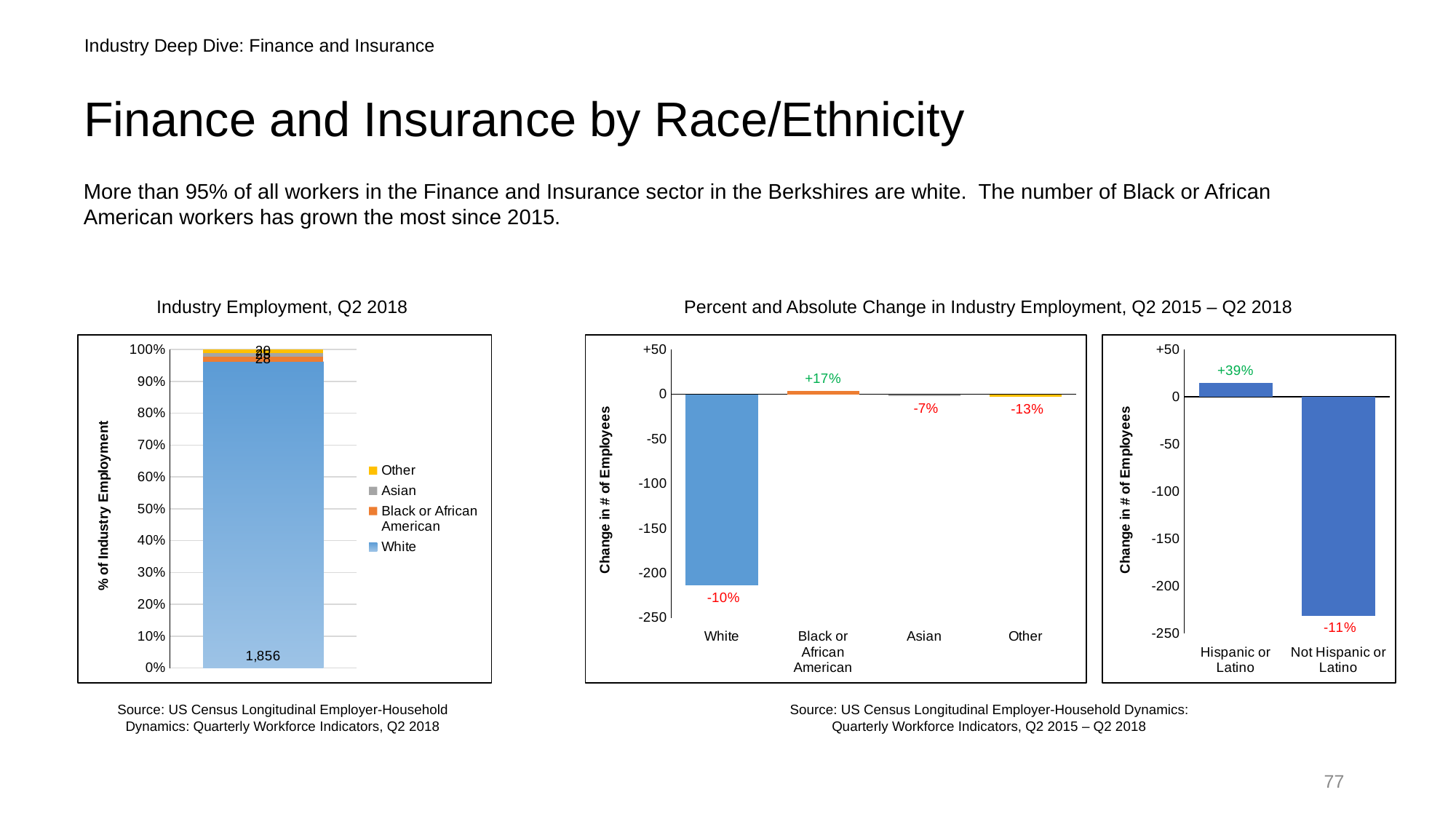
In the rightmost chart (Hispanic or Latino vs Not Hispanic or Latino), what is the percent change for Hispanic or Latino? +39% In the Industry Employment, Q2 2018 chart, what is the data label shown on the White segment? 1,856 In the rightmost chart, is the change in number of employees for Not Hispanic or Latino greater or less than -200? less How many race/ethnicity categories are shown on the x axis of the middle chart (Percent and Absolute Change in Industry Employment)? 4 In the Percent and Absolute Change in Industry Employment chart (middle), is the change in number of employees for White greater or less than -100? less In the Percent and Absolute Change in Industry Employment chart (middle), what is the percent change for White? -10% In the Percent and Absolute Change in Industry Employment chart (middle), which category has the largest decrease in number of employees? White In the Percent and Absolute Change in Industry Employment chart (middle), what is the percent change for Other? -13% What kind of chart is the Industry Employment, Q2 2018 chart? Stacked bar chart In the Percent and Absolute Change in Industry Employment chart (middle), what is the percent change for Asian? -7% In the Percent and Absolute Change in Industry Employment chart (middle), what is the percent change for Black or African American? +17% How many series does the legend of the Industry Employment, Q2 2018 chart list? 4